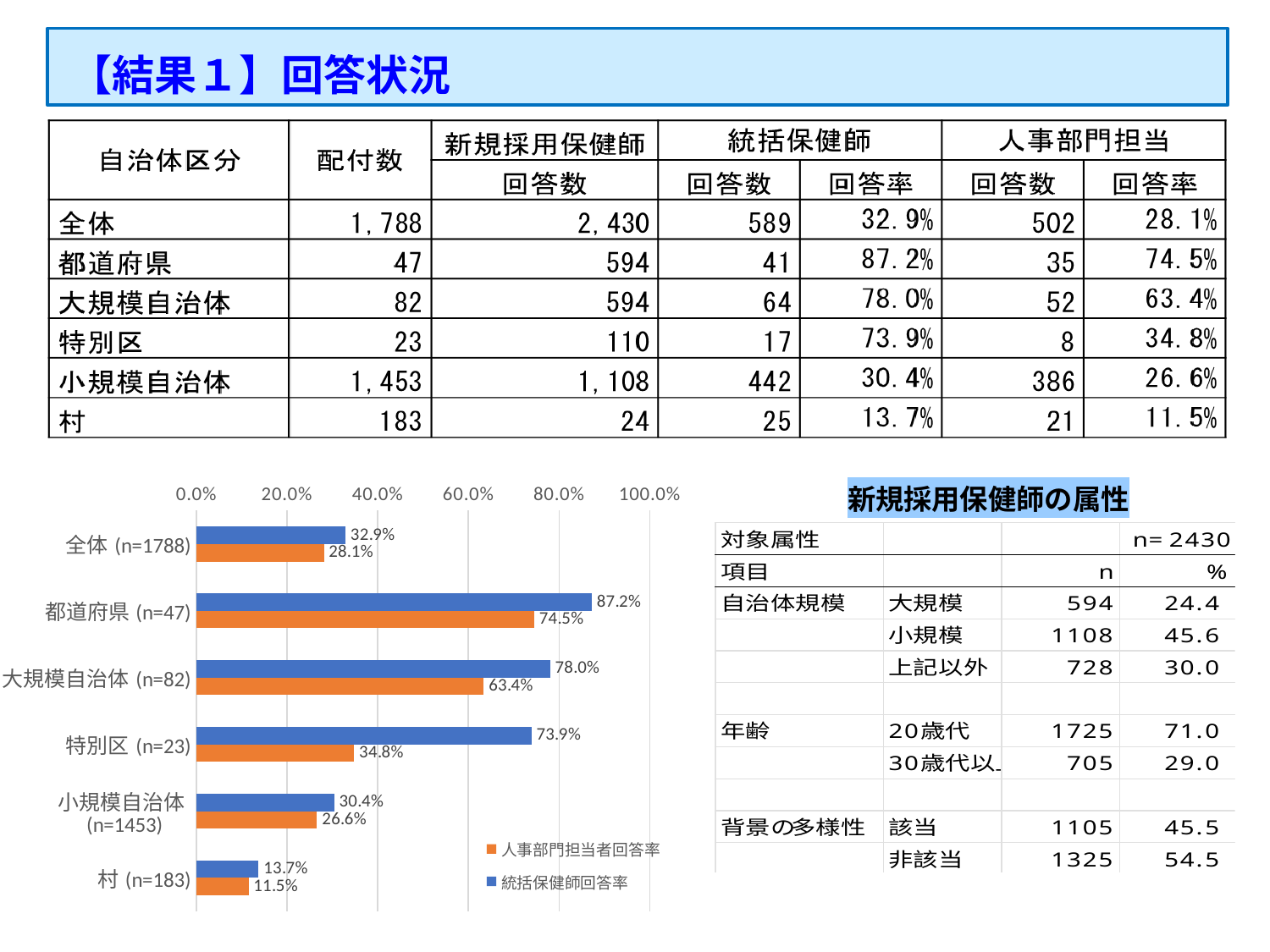
For 大規模自治体 (n=82), which is larger: the 統括保健師回答率 or the 人事部門担当者回答率? 統括保健師回答率 What is the difference between the 統括保健師回答率 and the 人事部門担当者回答率 for 特別区 (n=23)? 39.1% What type of chart is shown on the slide? bar chart How many series does the chart legend list? 2 Which colour represents 人事部門担当者回答率 in the chart? orange What is the 人事部門担当者回答率 value for 特別区 (n=23)? 34.8% Is the 統括保健師回答率 for 小規模自治体 (n=1453) greater or less than 40.0%? less How many categories are plotted on the chart? 6 What is the 人事部門担当者回答率 value for 村 (n=183)? 11.5% Which category has the highest 統括保健師回答率? 都道府県 (n=47) What is the 統括保健師回答率 value for 都道府県 (n=47)? 87.2% Which category has the lowest 人事部門担当者回答率? 村 (n=183)